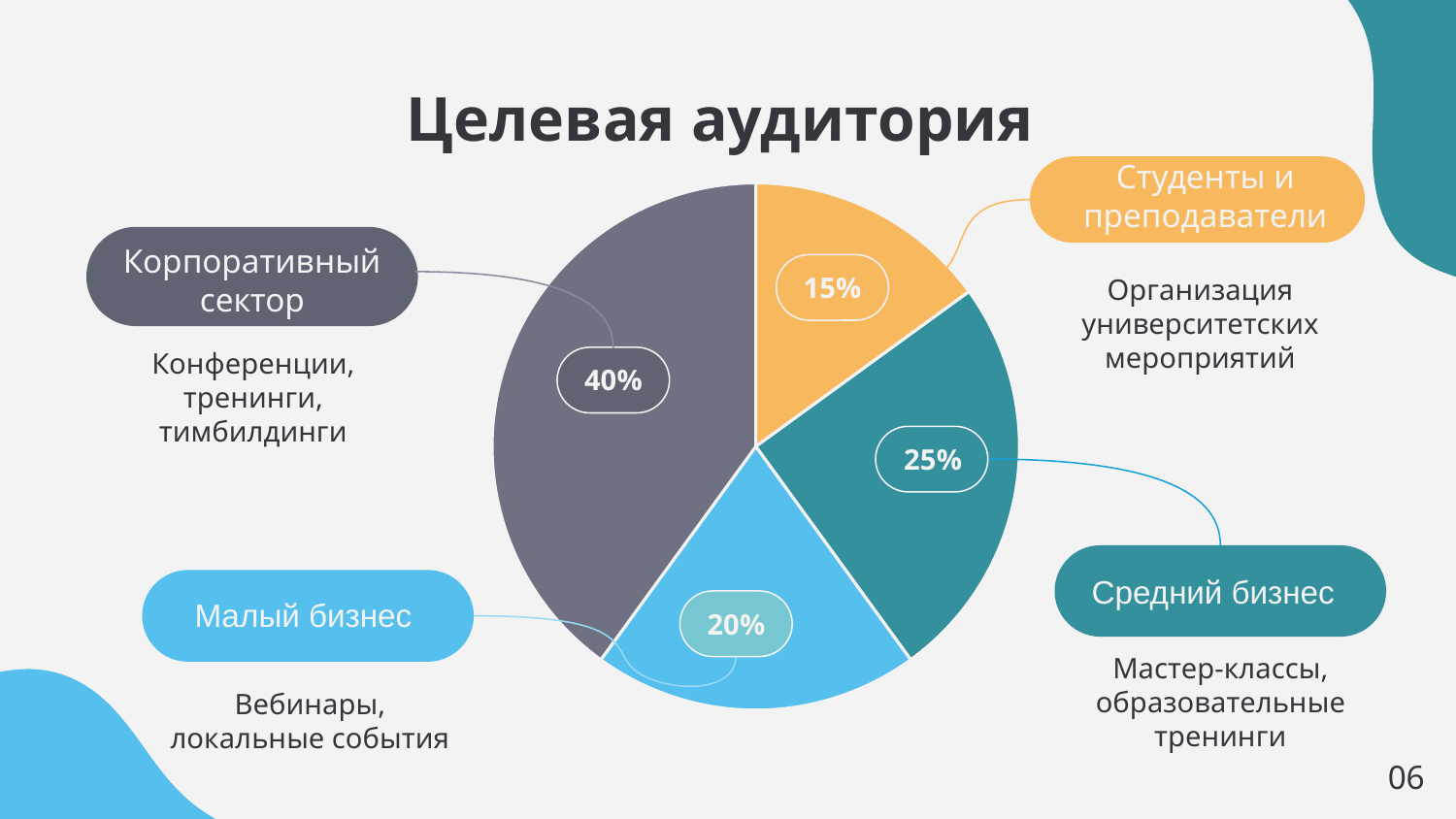
What kind of chart is shown on the slide? Pie chart Which is larger: the share for Средний бизнес or the share for Малый бизнес? Средний бизнес What share of the pie chart does Малый бизнес hold? 20% What is the title of the slide containing the chart? Целевая аудитория How many slices does the pie chart have? 4 What is the difference in percentage points between Корпоративный сектор and Малый бизнес? 20 What colour is the slice for Студенты и преподаватели? Orange Which category has the smallest slice of the pie chart? Студенты и преподаватели What share of the pie chart does Средний бизнес hold? 25% What share of the pie chart does Корпоративный сектор hold? 40% What share of the pie chart does Студенты и преподаватели hold? 15% Which category has the largest slice of the pie chart? Корпоративный сектор